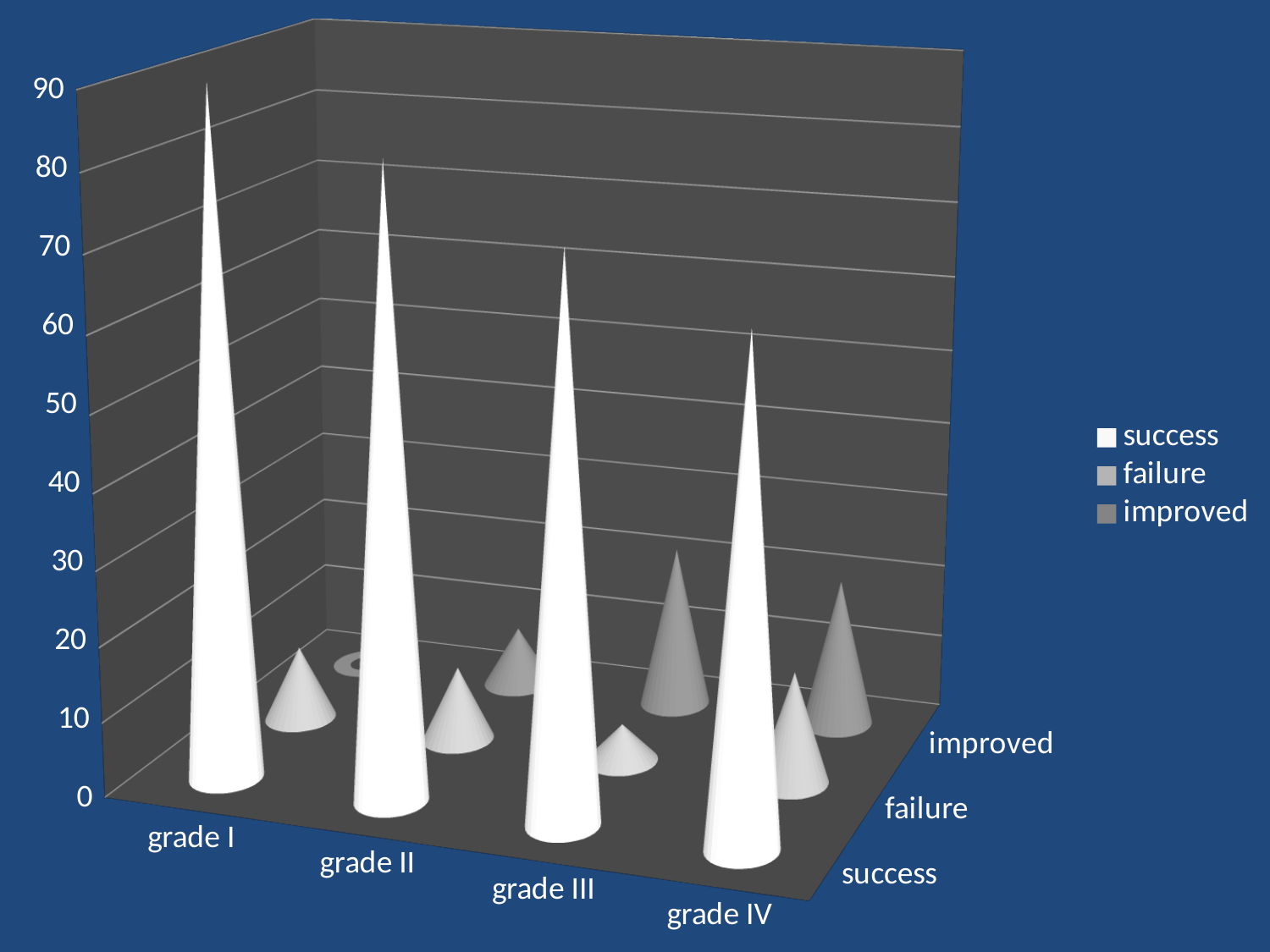
Is the success value for grade IV greater or less than 40? greater Which grade has the highest success value? grade I How many series does the legend list? 3 Which grade has the lowest success value? grade IV Do the success values rise or fall from grade I to grade IV? fall What kind of chart is shown on the slide? bar chart Is the success value for grade I greater or less than 70? greater How many grade categories are shown on the x axis? 4 Is the improved value for grade I greater or less than 10? less Which is larger for grade I, the success value or the failure value? success Which is larger, the success value for grade I or the success value for grade IV? grade I What are the three series named in the legend? success, failure, improved